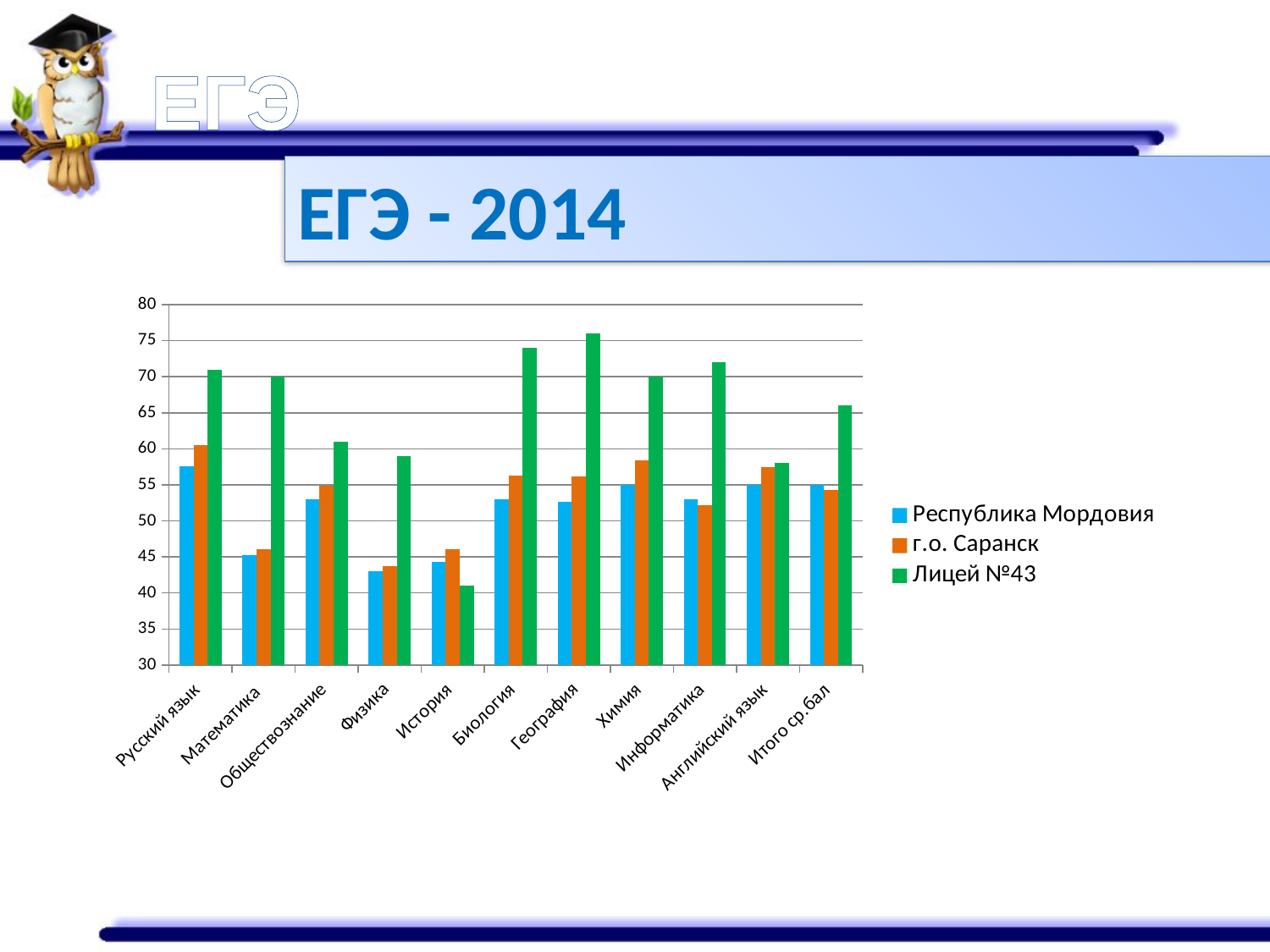
What is the title of the slide above the chart? ЕГЭ - 2014 Is the value for Лицей №43 in История greater or less than 45? less In История, which is larger: the value for г.о. Саранск or for Лицей №43? г.о. Саранск Which category has the highest value for Лицей №43? География Is the value for Республика Мордовия in Математика greater or less than 50? less How many series does the legend list? 3 Is the value for Лицей №43 in Биология greater or less than 70? greater What kind of chart is shown on the slide? bar chart Which category has the lowest value for Лицей №43? История How many categories are shown along the x axis? 11 In Физика, which is larger: the value for Республика Мордовия or for Лицей №43? Лицей №43